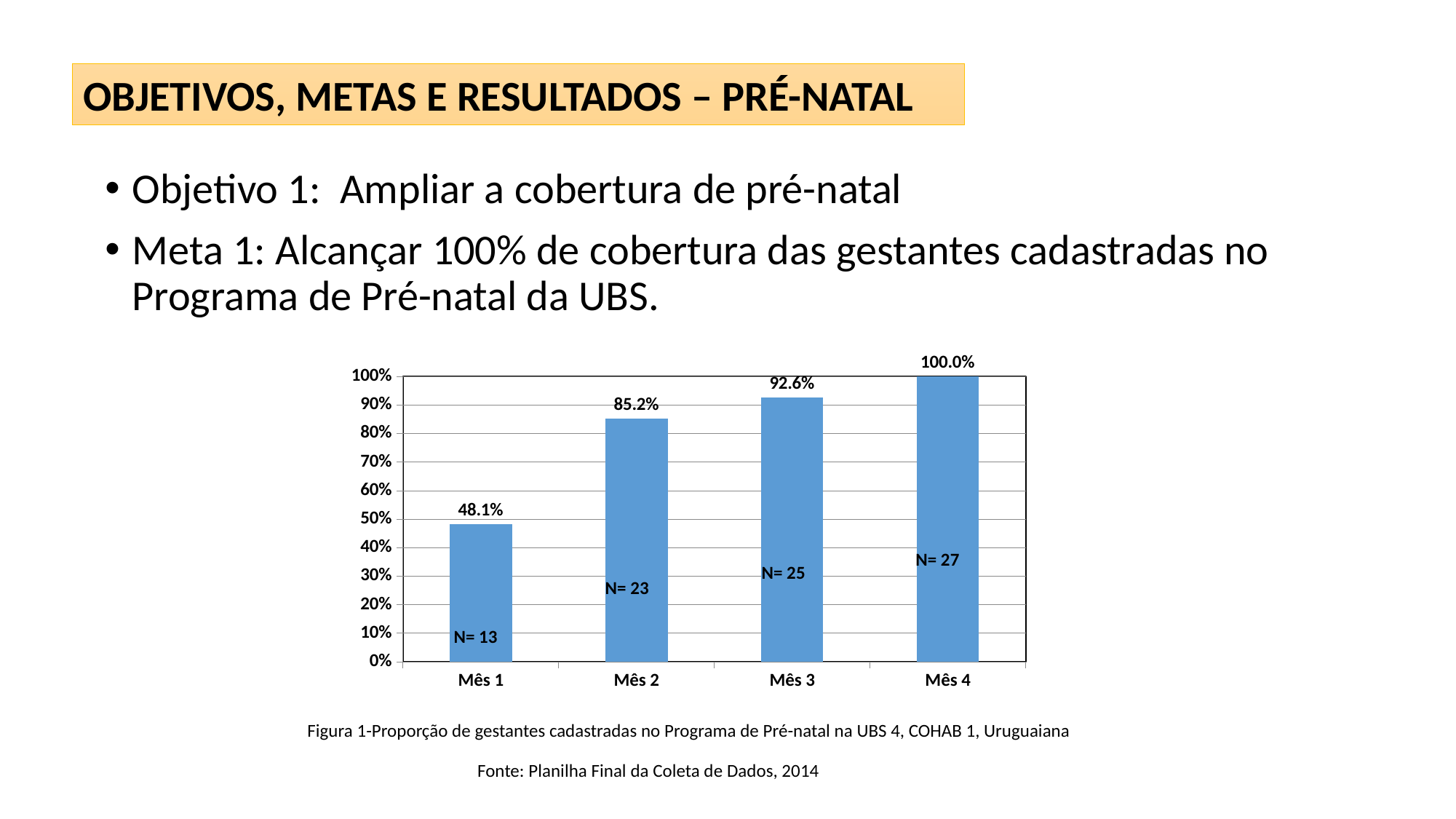
Which is larger, the value for Mês 2 or the value for Mês 3? Mês 3 What kind of chart is shown on the slide? bar chart What is the N value shown inside the bar for Mês 2? N= 23 Which month has the lowest value? Mês 1 What is the value for Mês 1? 48.1% Which month has the highest value? Mês 4 What is the difference between the values for Mês 2 and Mês 1? 37.1% How many months are shown on the x axis? 4 What is the value for Mês 3? 92.6% What is the source cited below the chart? Planilha Final da Coleta de Dados, 2014 Is the value for Mês 2 greater or less than 80%? greater Do the values rise or fall from Mês 1 to Mês 4? rise